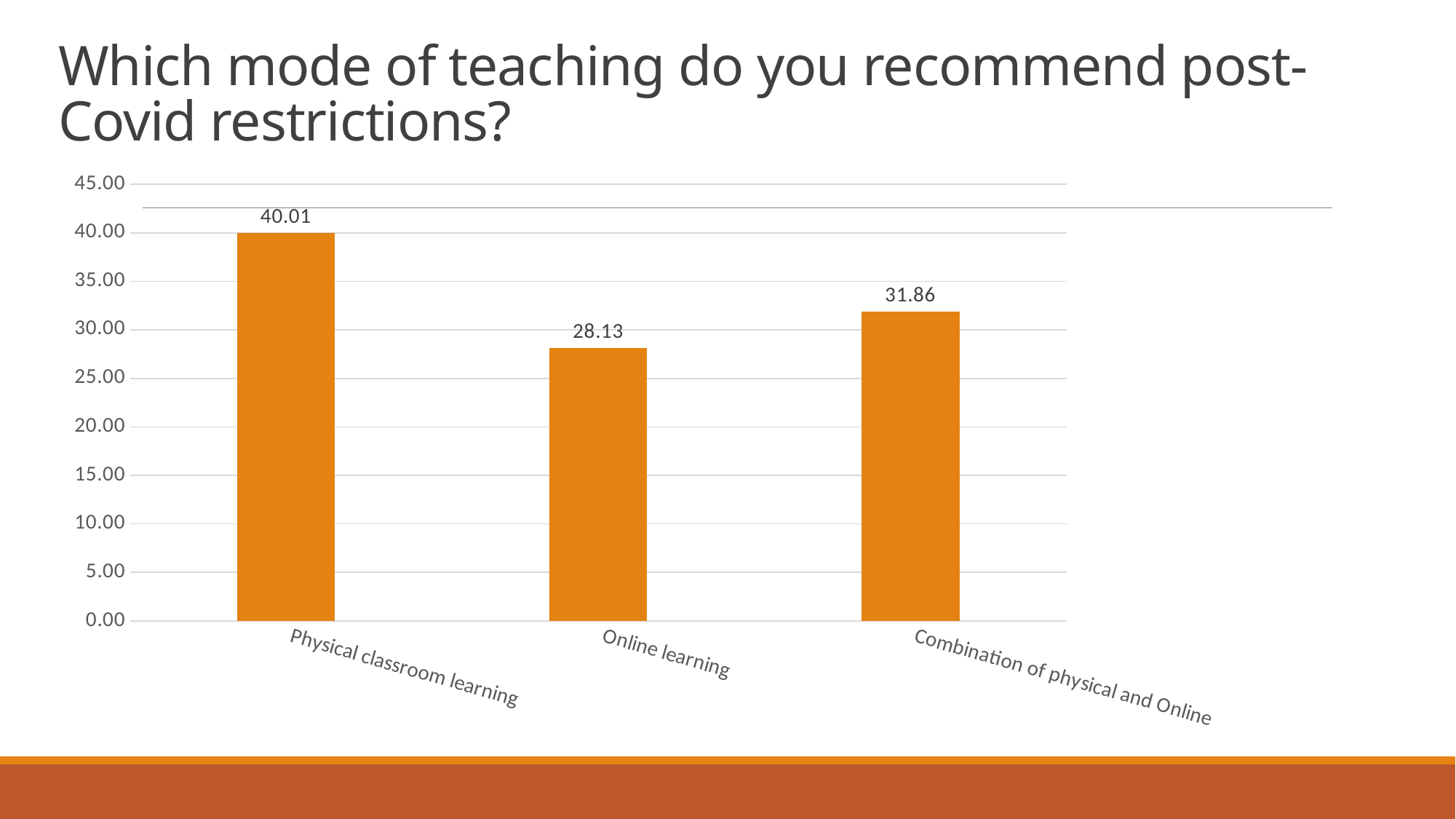
Which mode of teaching has the highest value? Physical classroom learning How many categories are shown on the chart? 3 What is the value for Combination of physical and Online? 31.86 What is the value for Online learning? 28.13 What kind of chart is shown on the slide? Bar chart What is the difference between the values for Combination of physical and Online and Online learning? 3.73 Is the value for Combination of physical and Online greater or less than 35.00? less Which is larger, the value for Online learning or the value for Combination of physical and Online? Combination of physical and Online What colour are the bars in the chart? Orange Which mode of teaching has the lowest value? Online learning What is the difference between the values for Physical classroom learning and Online learning? 11.88 What is the value for Physical classroom learning? 40.01